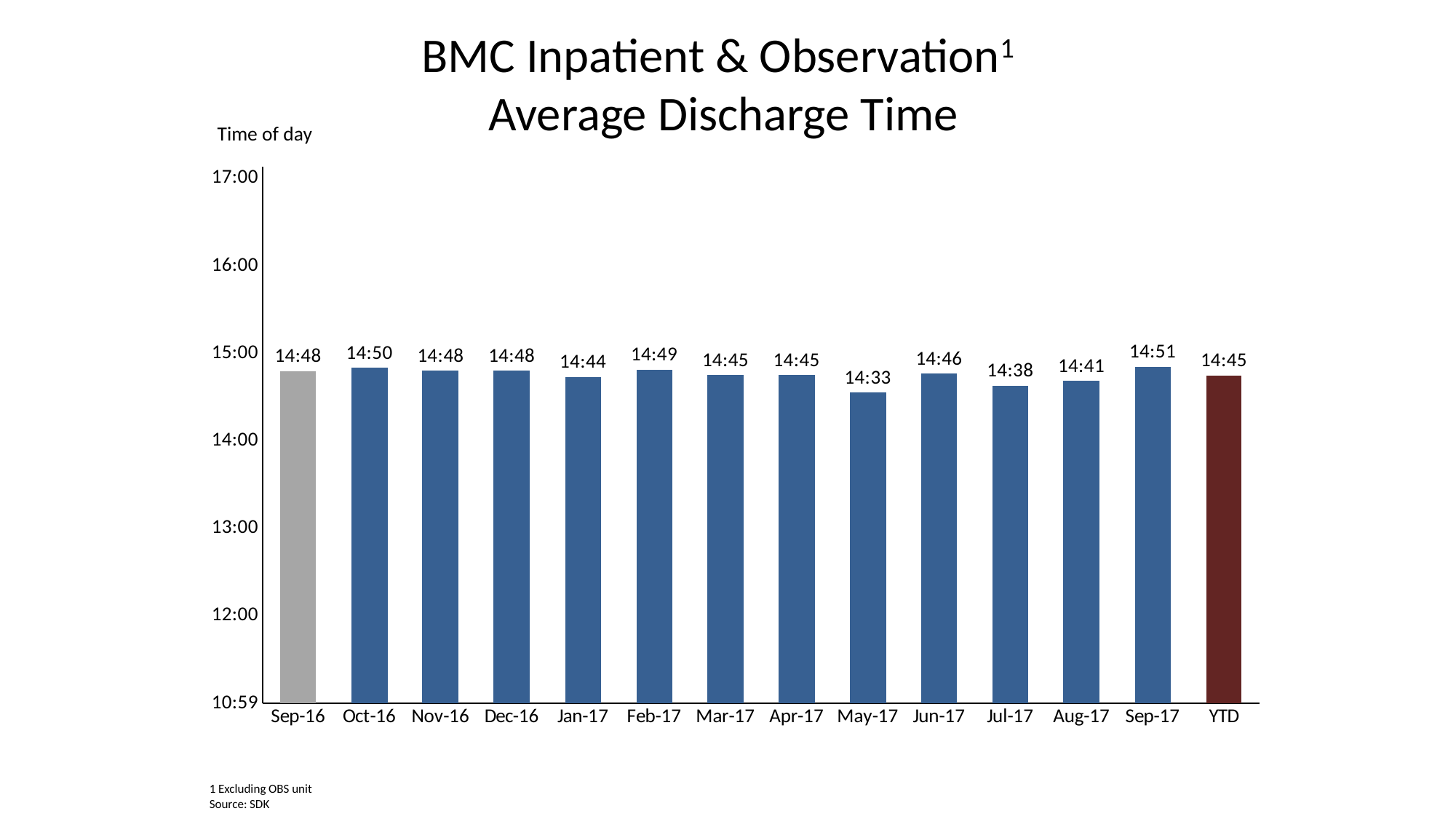
Which category has the latest (highest) average discharge time? Sep-17 What is the average discharge time for Sep-17? 14:51 Which category has the earliest (lowest) average discharge time? May-17 What kind of chart is shown on the slide? Bar chart What is the average discharge time for May-17? 14:33 Which is later, the average discharge time for Oct-16 or for Jan-17? Oct-16 What is the YTD average discharge time? 14:45 Is the value for Aug-17 greater or less than 15:00? less How many minutes later is the Sep-17 average discharge time than the May-17 time? 18 minutes What is the average discharge time for Jul-17? 14:38 What is the label on the vertical axis of the chart? Time of day How many bars are shown in the chart? 14